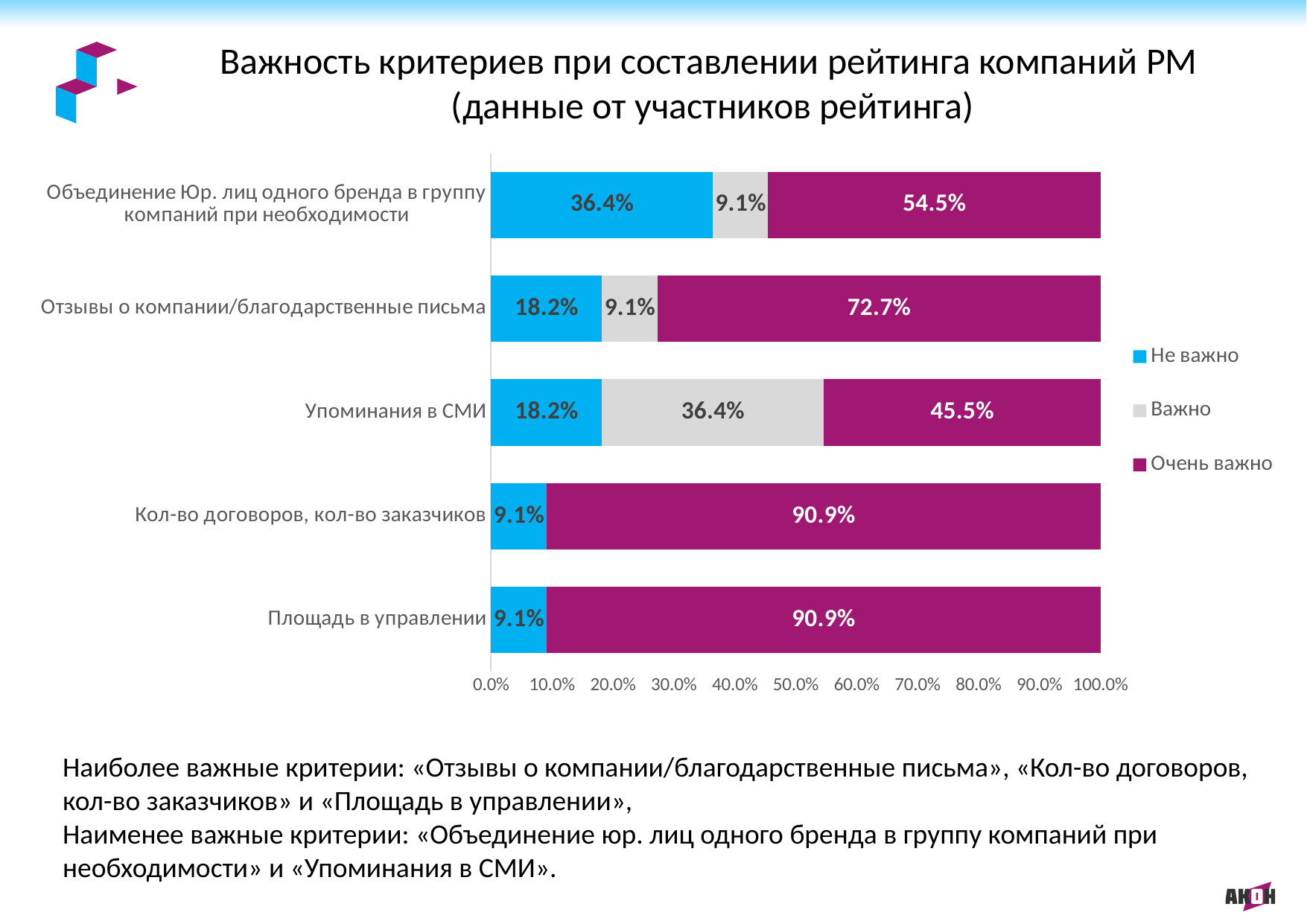
Which legend entry is shown in magenta? Очень важно What is the 'Очень важно' value for 'Площадь в управлении'? 90.9% What type of chart is shown on the slide? Stacked bar chart What is the difference between the 'Очень важно' values for 'Кол-во договоров, кол-во заказчиков' and 'Упоминания в СМИ'? 45.4% Which criterion has the lowest 'Очень важно' value? Упоминания в СМИ What is the 'Очень важно' value for 'Отзывы о компании/благодарственные письма'? 72.7% What is the 'Не важно' value for 'Объединение Юр. лиц одного бренда в группу компаний при необходимости'? 36.4% Which is larger: the 'Очень важно' value for 'Отзывы о компании/благодарственные письма' or for 'Объединение Юр. лиц одного бренда в группу компаний при необходимости'? Отзывы о компании/благодарственные письма How many series does the legend list? 3 Which criterion has the highest 'Не важно' value? Объединение Юр. лиц одного бренда в группу компаний при необходимости How many criteria (categories) are plotted in the chart? 5 What is the 'Важно' value for 'Упоминания в СМИ'? 36.4%